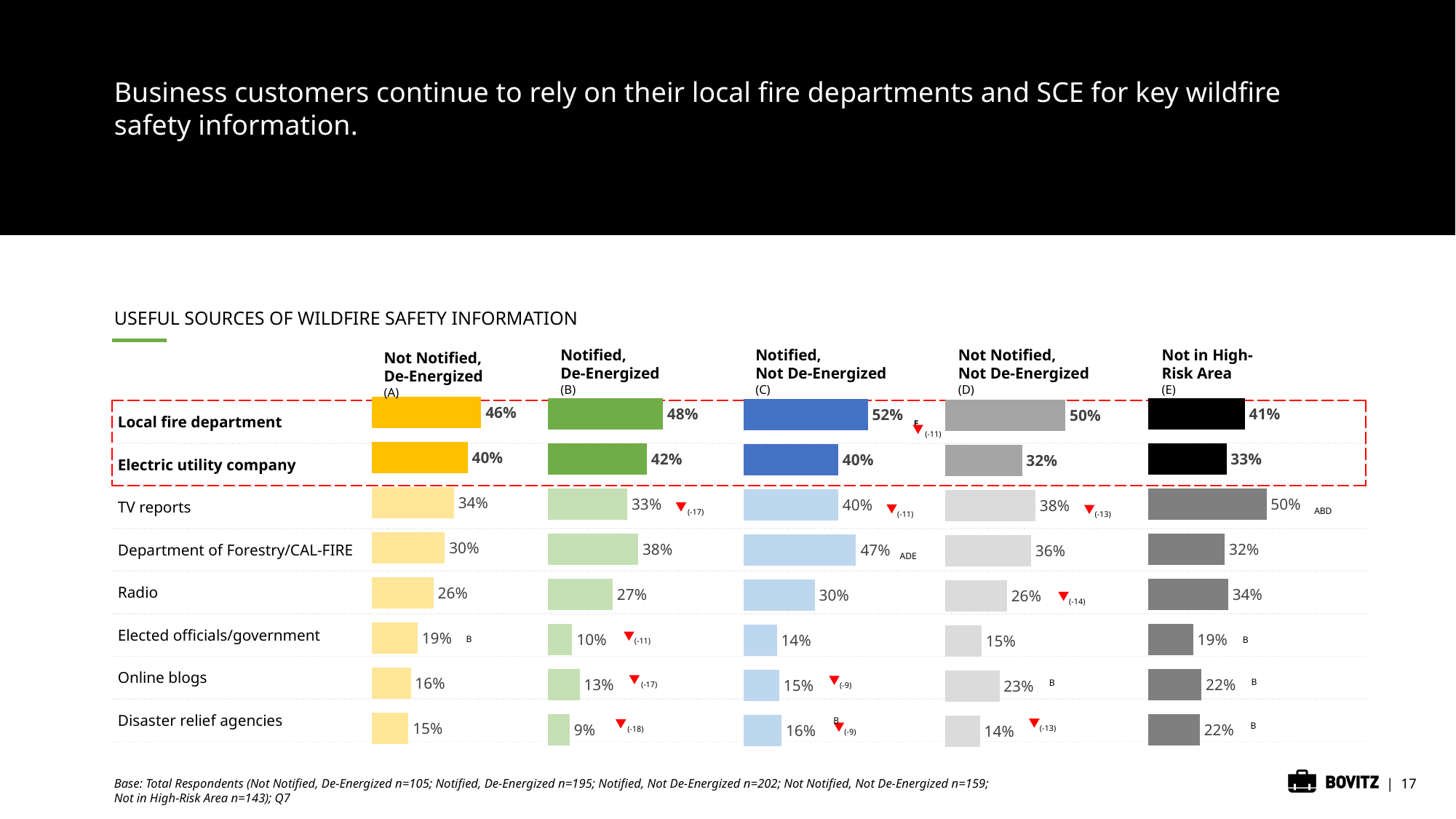
What is the value for Disaster relief agencies among Notified, De-Energized (B) customers? 9% What type of chart is used to show the useful sources of wildfire safety information? Bar chart Which segment has the highest value for Electric utility company? Notified, De-Energized (B) What is the difference between the Local fire department values for Notified, Not De-Energized (C) and Not in High-Risk Area (E)? 11 percentage points How many customer segments are shown as columns in the chart? 5 Which source has the lowest value among Notified, De-Energized (B) customers? Disaster relief agencies How many sources of wildfire safety information are listed in the chart? 8 What is the value for Department of Forestry/CAL-FIRE among Notified, De-Energized (B) customers? 38% Which is larger for Not Notified, Not De-Energized (D) customers: Online blogs or Disaster relief agencies? Online blogs What percentage of Notified, Not De-Energized (C) business customers cite the local fire department as a useful source of wildfire safety information? 52% What percentage of Not in High-Risk Area (E) customers cite TV reports as a useful source? 50% Which source has the highest value among Not Notified, De-Energized (A) customers? Local fire department